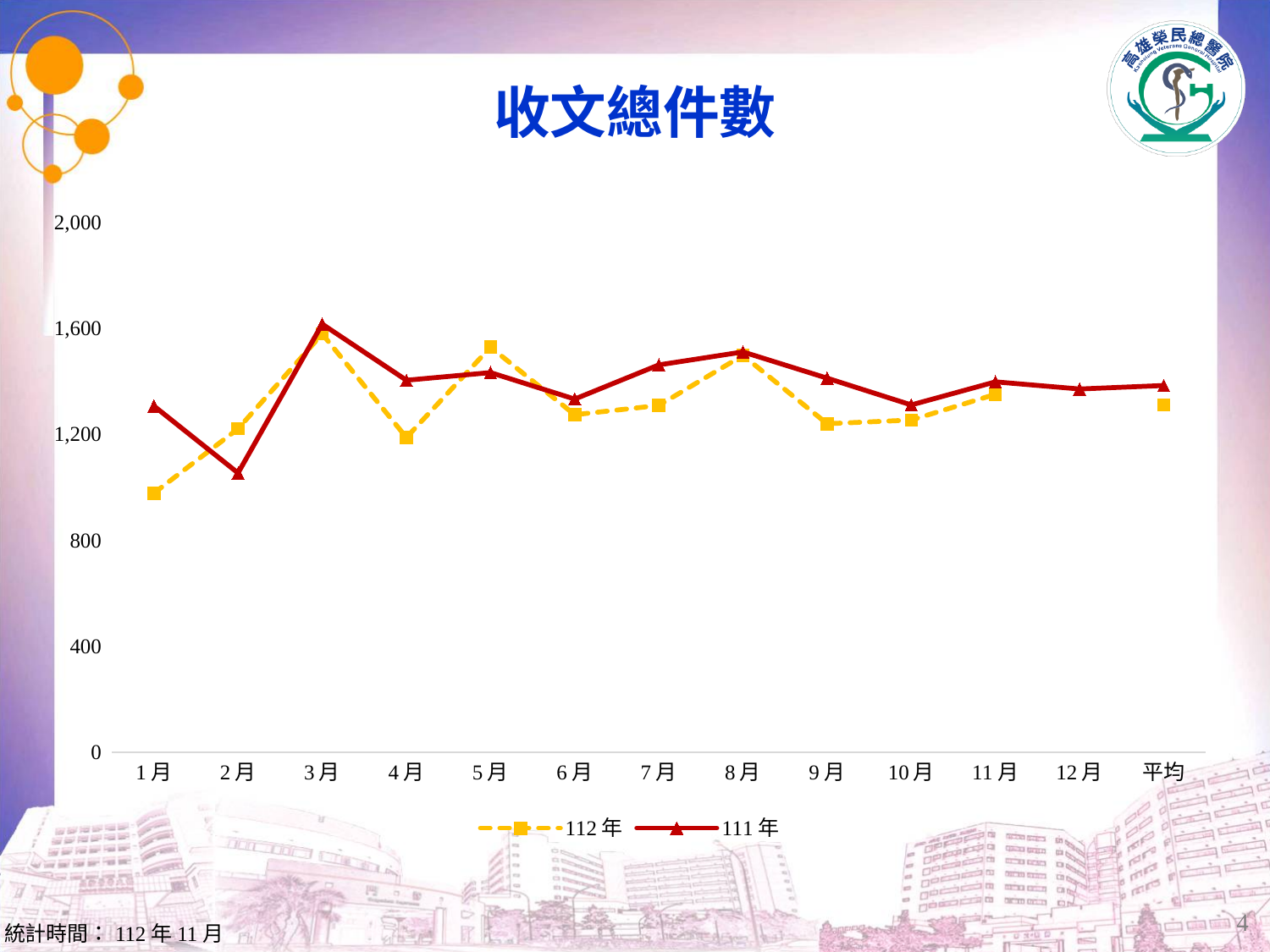
In which month does the 111年 series have its lowest value? 2月 How many series does the legend list? 2 What is the title of the chart? 收文總件數 Is the value for 112年 in 1月 greater or less than 1,200? less In 5月, which series has the larger value, 112年 or 111年? 112年 Which series is drawn with a dashed line? 112年 In which month does the 111年 series reach its highest value? 3月 What kind of chart is shown on the slide? line chart Does the 112年 series rise or fall from 1月 to 3月? rise In which month does the 112年 series have its lowest value? 1月 How many categories are shown along the x axis? 13